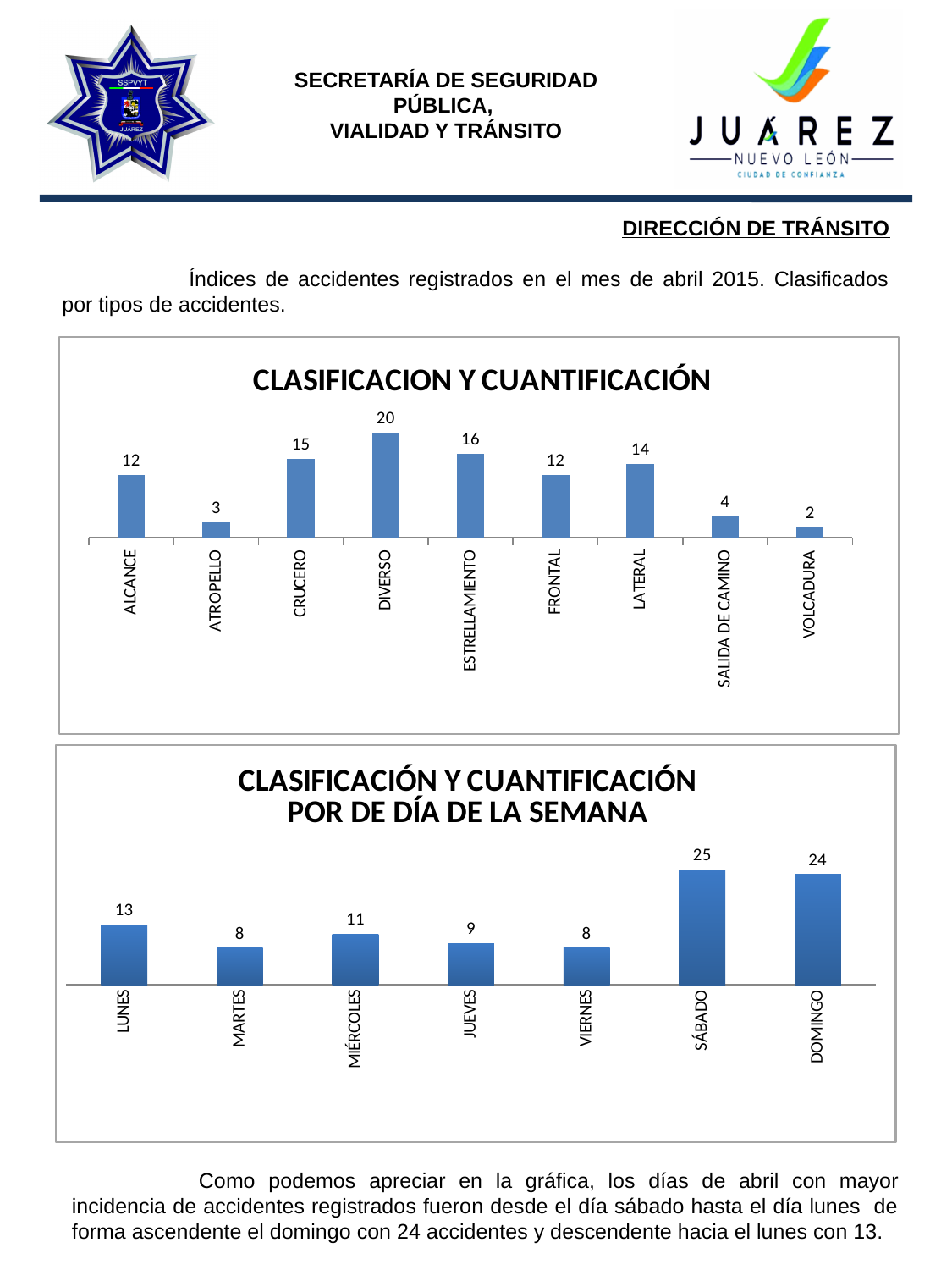
In the 'CLASIFICACION Y CUANTIFICACIÓN' chart, what is the value for DIVERSO? 20 In the 'CLASIFICACION Y CUANTIFICACIÓN' chart, which is larger, CRUCERO or LATERAL? CRUCERO What type of chart is the bottom chart on the slide? Bar chart In the 'CLASIFICACIÓN Y CUANTIFICACIÓN POR DE DÍA DE LA SEMANA' chart, how many days are shown? 7 In the 'CLASIFICACION Y CUANTIFICACIÓN' chart, what is the difference between ESTRELLAMIENTO and ATROPELLO? 13 In the 'CLASIFICACION Y CUANTIFICACIÓN' chart, how many categories are shown? 9 In the 'CLASIFICACIÓN Y CUANTIFICACIÓN POR DE DÍA DE LA SEMANA' chart, what is the difference between DOMINGO and LUNES? 11 In the 'CLASIFICACIÓN Y CUANTIFICACIÓN POR DE DÍA DE LA SEMANA' chart, what is the value for SÁBADO? 25 In the 'CLASIFICACION Y CUANTIFICACIÓN' chart, which category has the lowest value? VOLCADURA In the 'CLASIFICACIÓN Y CUANTIFICACIÓN POR DE DÍA DE LA SEMANA' chart, which day has the highest value? SÁBADO In the 'CLASIFICACION Y CUANTIFICACIÓN' chart, which category has the highest value? DIVERSO In the 'CLASIFICACIÓN Y CUANTIFICACIÓN POR DE DÍA DE LA SEMANA' chart, which is larger, MIÉRCOLES or JUEVES? MIÉRCOLES